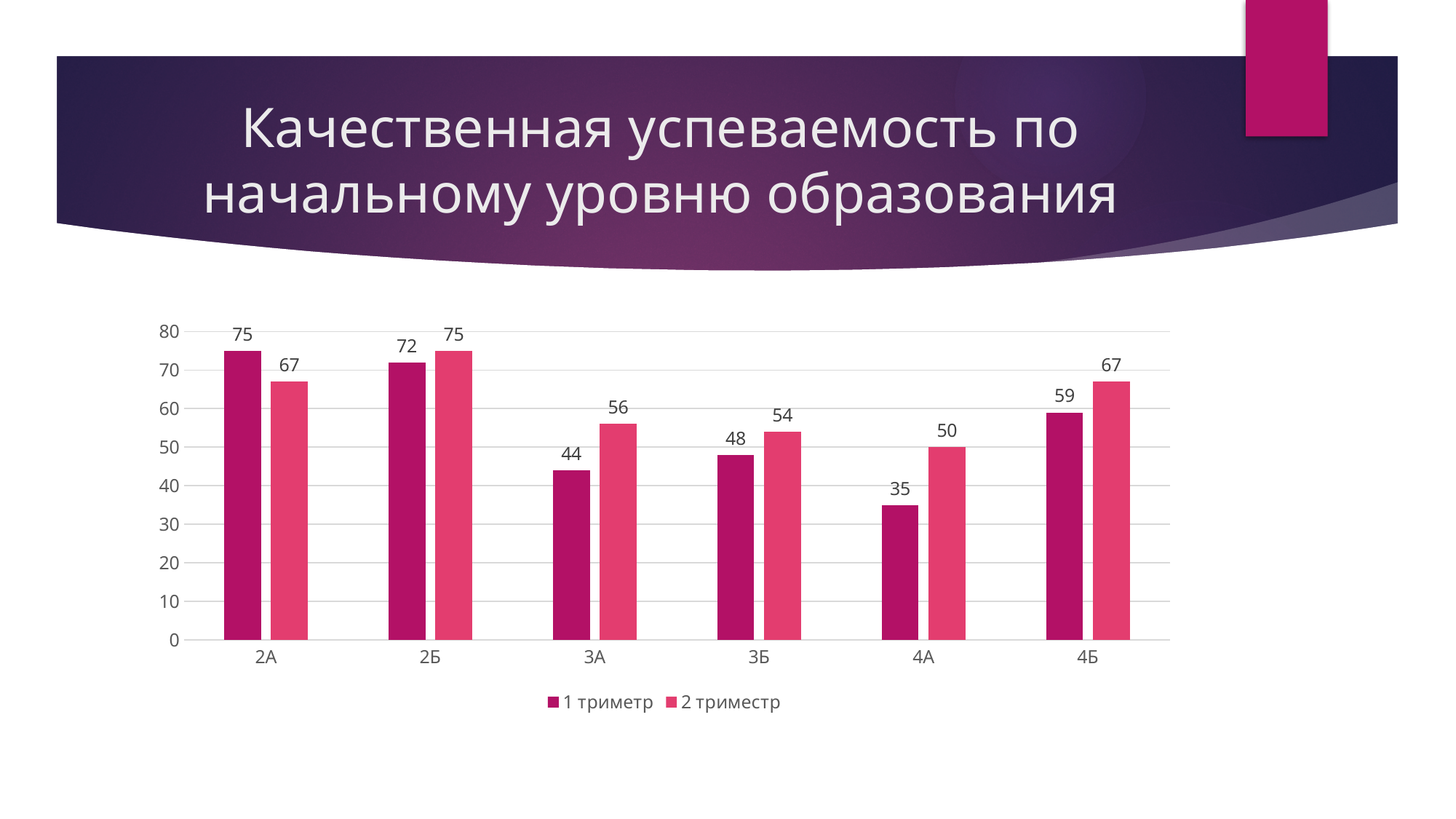
Which is larger for 2А: the 1 триметр value or the 2 триместр value? 1 триметр Is the 1 триметр value for 3А greater or less than 50? less How many series does the legend list? 2 What is the value for 2А in the 1 триметр series? 75 What is the difference between the 2 триместр and 1 триметр values for 4А? 15 Which category has the lowest value in the 1 триметр series? 4А Which category has the highest value in the 2 триместр series? 2Б How many categories are shown on the x axis? 6 What is the value for 3Б in the 1 триметр series? 48 What kind of chart is shown on the slide? bar chart What is the title of the slide? Качественная успеваемость по начальному уровню образования What is the value for 4А in the 2 триместр series? 50